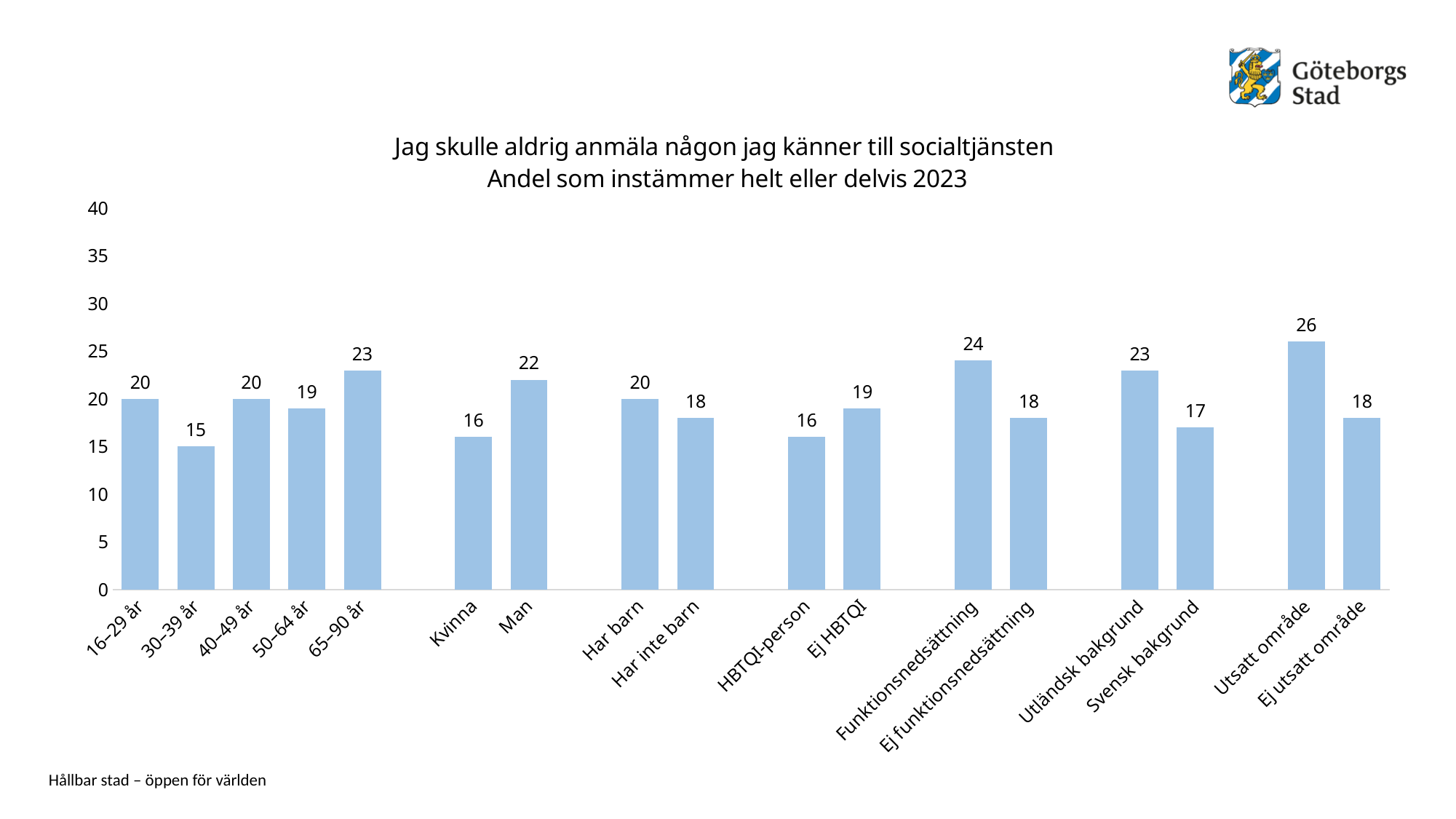
Which category has the lowest value? 30–39 år Which is larger, the value for Har barn or the value for Har inte barn? Har barn Is the value for 65–90 år greater or less than 20? greater Which category has the highest value? Utsatt område What is the value for Kvinna? 16 How many categories are shown on the x axis? 17 What is the difference between the values for Utländsk bakgrund and Svensk bakgrund? 6 What year does the chart title refer to? 2023 What kind of chart is this? Bar chart What is the value for Utsatt område? 26 What is the difference between the values for Man and Kvinna? 6 What is the value for Funktionsnedsättning? 24